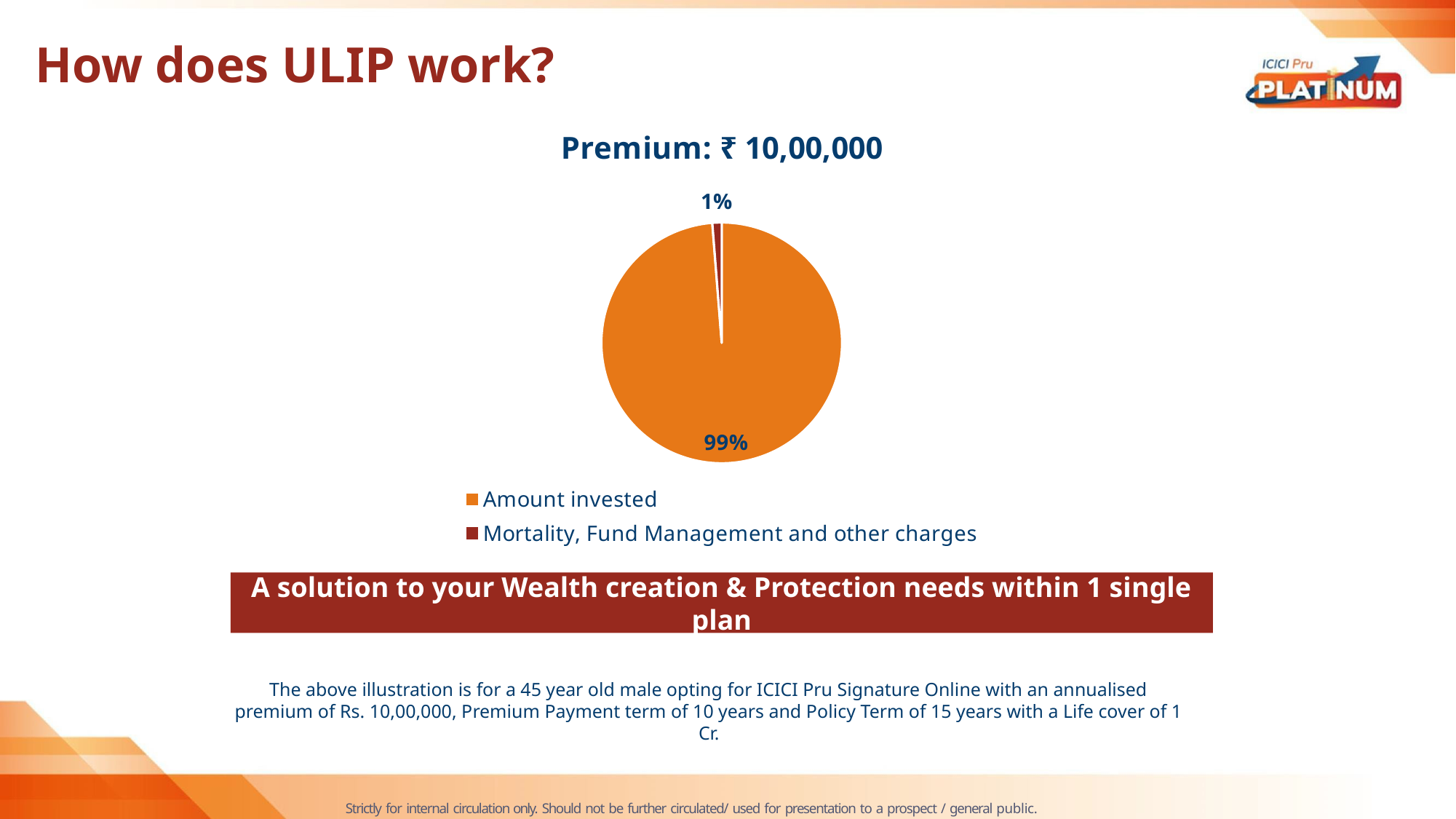
What is the title shown above the pie chart? Premium: ₹ 10,00,000 What colour is the Amount invested slice? orange What share of the premium is shown as Amount invested? 99% Which is larger: the Amount invested slice or the Mortality, Fund Management and other charges slice? Amount invested What is the difference in percentage points between the Amount invested slice and the Mortality, Fund Management and other charges slice? 98 What kind of chart is shown on the slide? pie chart Which slice of the pie is the smallest? Mortality, Fund Management and other charges How many entries does the legend list? 2 How many slices does the pie chart have? 2 What share of the premium goes to Mortality, Fund Management and other charges? 1% Which slice of the pie is the largest? Amount invested